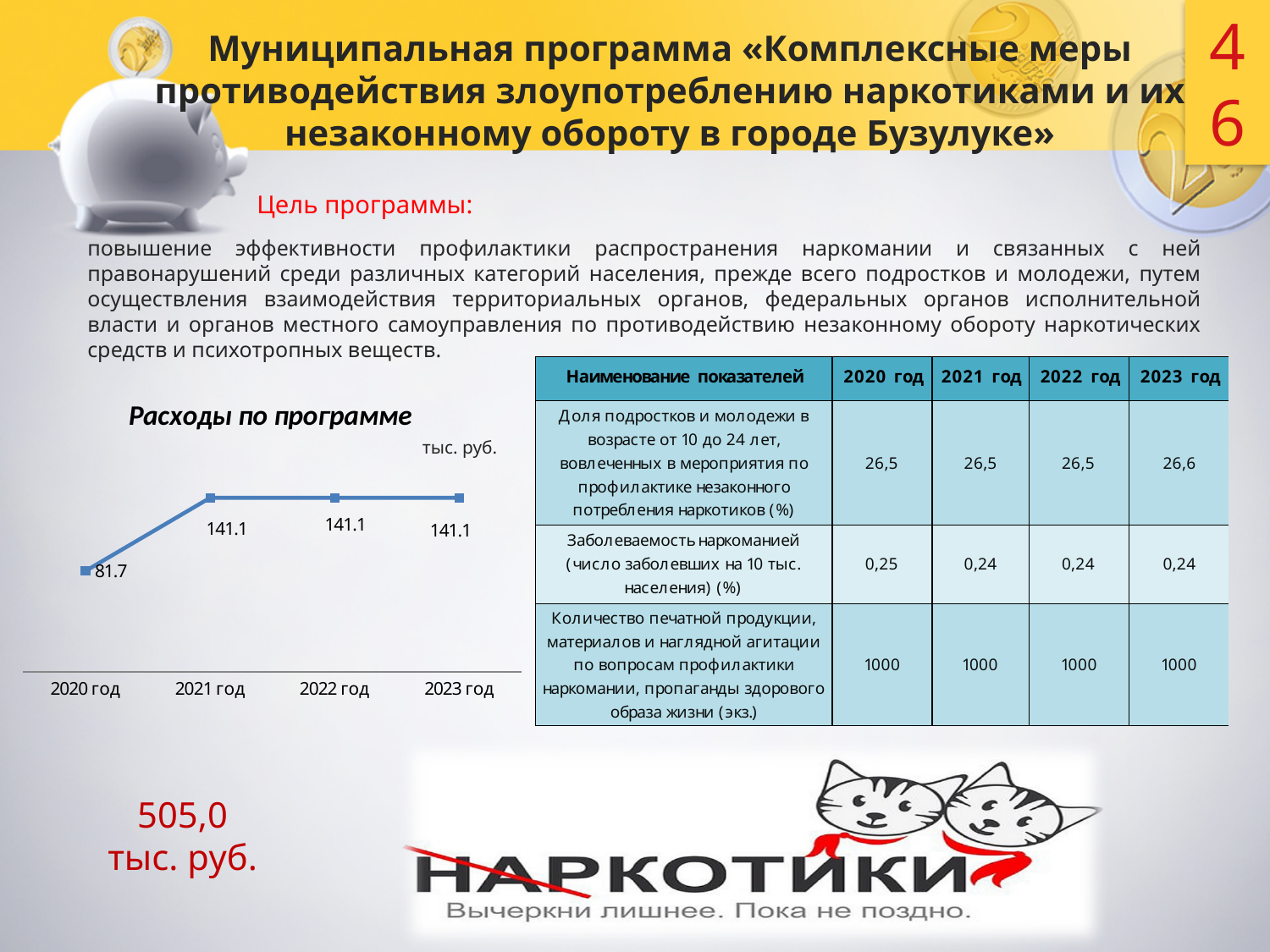
In the "Расходы по программе" chart, which is larger: the value for 2020 год or the value for 2022 год? 2022 год What is the title of the line chart on the slide? Расходы по программе Which year has the lowest value in the "Расходы по программе" chart? 2020 год What unit is shown for the values in the "Расходы по программе" chart? тыс. руб. Does the line in the "Расходы по программе" chart rise or fall from 2020 год to 2021 год? rise What is the value for 2020 год in the "Расходы по программе" chart? 81.7 What is the value for 2023 год in the "Расходы по программе" chart? 141.1 Do the values in the "Расходы по программе" chart change between 2021 год and 2023 год? No, they stay at 141.1 How many years are plotted in the "Расходы по программе" chart? 4 What type of chart is "Расходы по программе"? line chart What is the value for 2021 год in the "Расходы по программе" chart? 141.1 What is the difference between the values for 2021 год and 2020 год in the "Расходы по программе" chart? 59.4